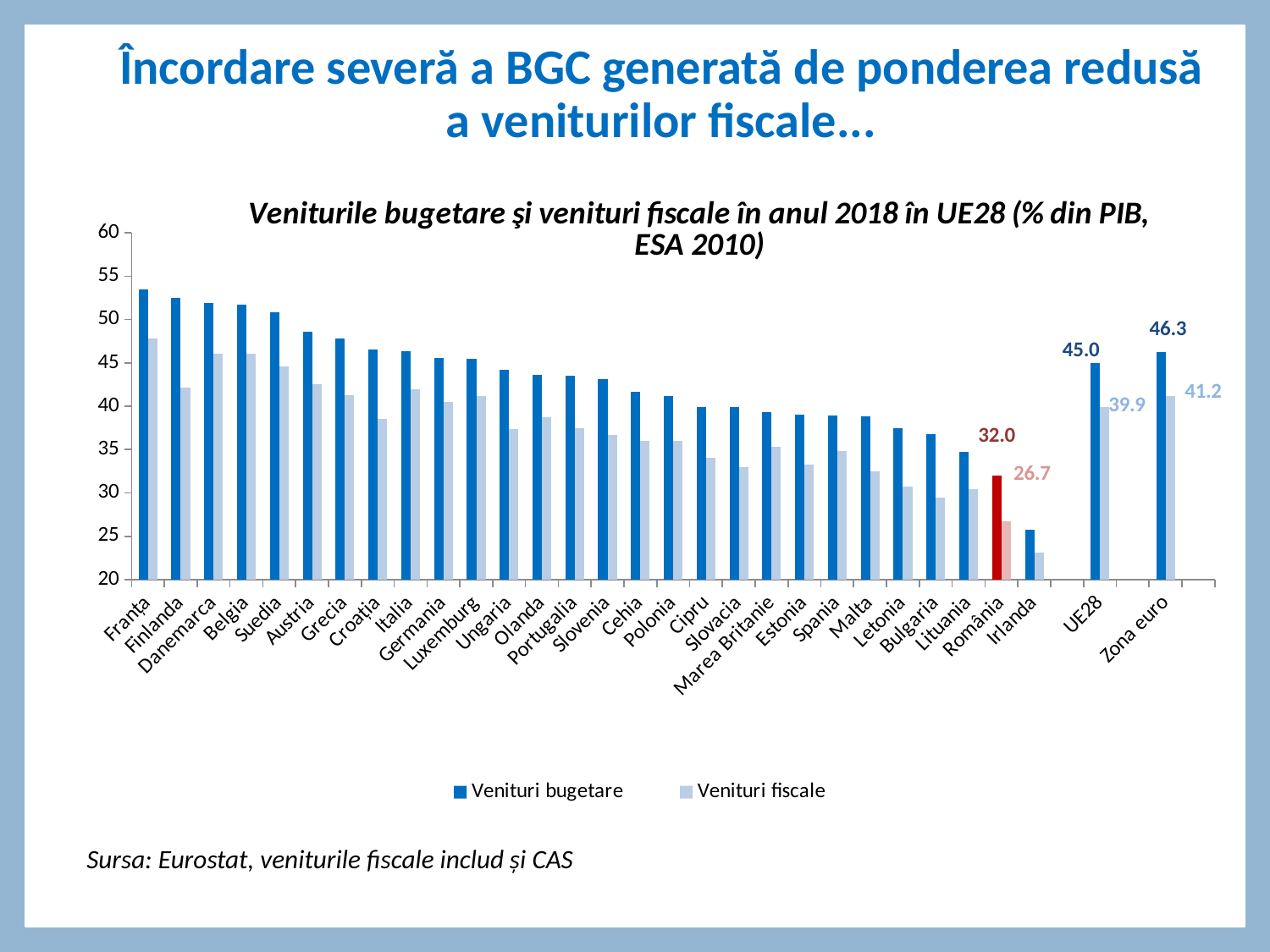
What is the value of Venituri fiscale for România? 26.7 Which has the higher Venituri bugetare value, UE28 or Zona euro? Zona euro What is the value of Venituri bugetare for UE28? 45.0 Which country has the highest Venituri bugetare value? Franța What is the value of Venituri fiscale for Zona euro? 41.2 Which country's bars are highlighted in red? România Is the Venituri bugetare value for Franța greater or less than 50? greater What is the value of Venituri bugetare for România? 32.0 Is the Venituri fiscale value for Irlanda greater or less than 25? less What is the difference between Venituri bugetare and Venituri fiscale for România? 5.3 Which country has the lowest Venituri bugetare value? Irlanda How many series does the legend list? 2